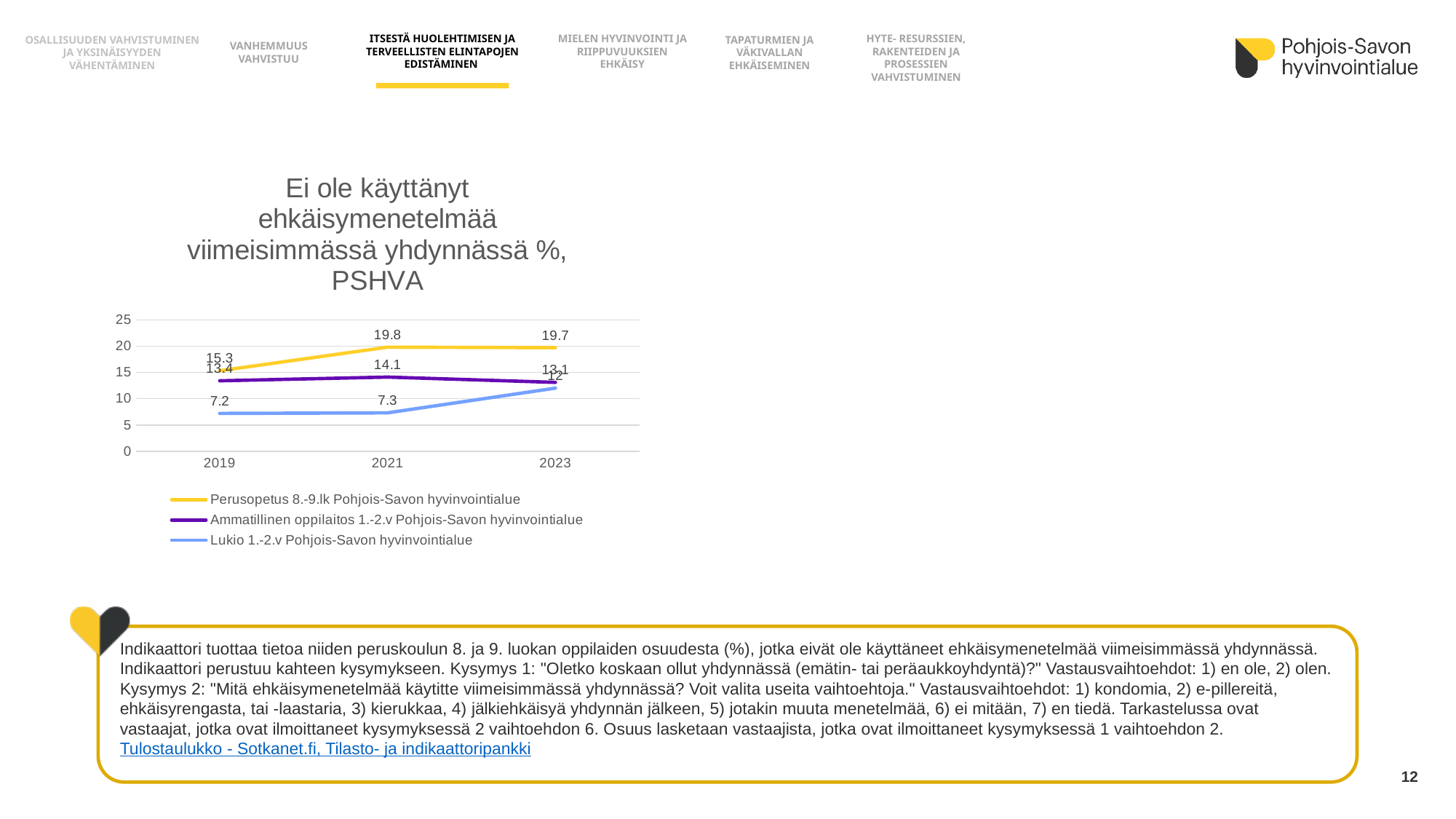
Which series has the highest value in 2023? Perusopetus 8.-9.lk Pohjois-Savon hyvinvointialue What is the value for Perusopetus 8.-9.lk Pohjois-Savon hyvinvointialue in 2021? 19.8 Which is larger in 2021: the value for Ammatillinen oppilaitos 1.-2.v or the value for Lukio 1.-2.v? Ammatillinen oppilaitos 1.-2.v Pohjois-Savon hyvinvointialue How many series does the legend list? 3 What is the value for Lukio 1.-2.v Pohjois-Savon hyvinvointialue in 2023? 12 What is the value for Ammatillinen oppilaitos 1.-2.v Pohjois-Savon hyvinvointialue in 2019? 13.4 What colour is the line for Lukio 1.-2.v Pohjois-Savon hyvinvointialue? light blue In which year is the value for Perusopetus 8.-9.lk Pohjois-Savon hyvinvointialue lowest? 2019 What type of chart is shown on the slide? line chart Does the value for Lukio 1.-2.v Pohjois-Savon hyvinvointialue rise or fall from 2021 to 2023? rise What is the difference between the Perusopetus 8.-9.lk value in 2021 and in 2019? 4.5 How many years are shown on the x axis? 3